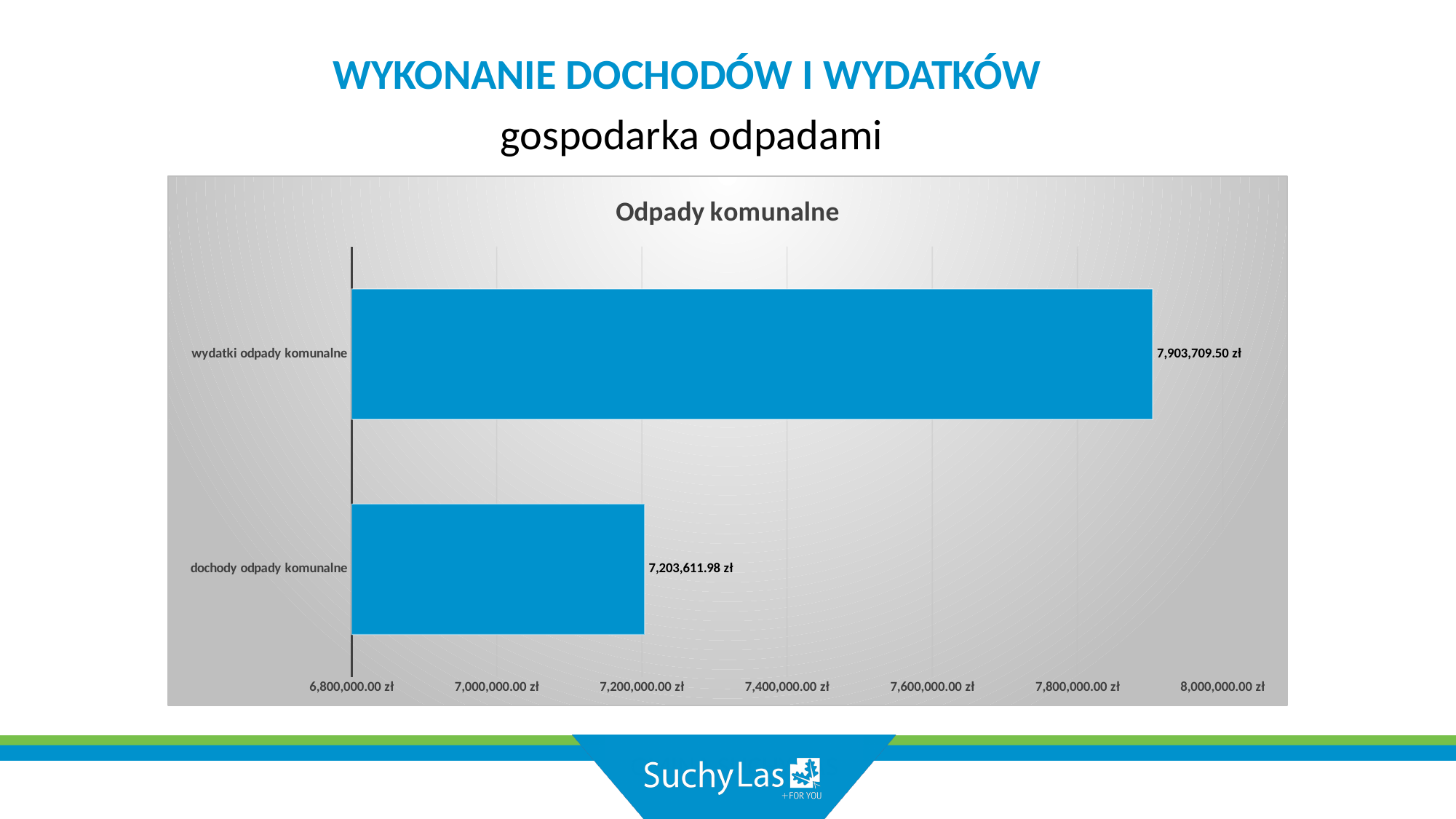
Is the value for dochody odpady komunalne greater or less than 7,400,000.00 zł? less What kind of chart is shown on the slide? bar chart What is the value for dochody odpady komunalne? 7,203,611.98 zł Which category has the lowest value? dochody odpady komunalne Is the value for wydatki odpady komunalne greater or less than 7,800,000.00 zł? greater What is the highest value shown on the horizontal axis? 8,000,000.00 zł Which is larger, wydatki odpady komunalne or dochody odpady komunalne? wydatki odpady komunalne What is the value for wydatki odpady komunalne? 7,903,709.50 zł How many categories are shown in the chart? 2 What is the title of the chart? Odpady komunalne Which category has the highest value? wydatki odpady komunalne What is the difference between wydatki odpady komunalne and dochody odpady komunalne? 700,097.52 zł